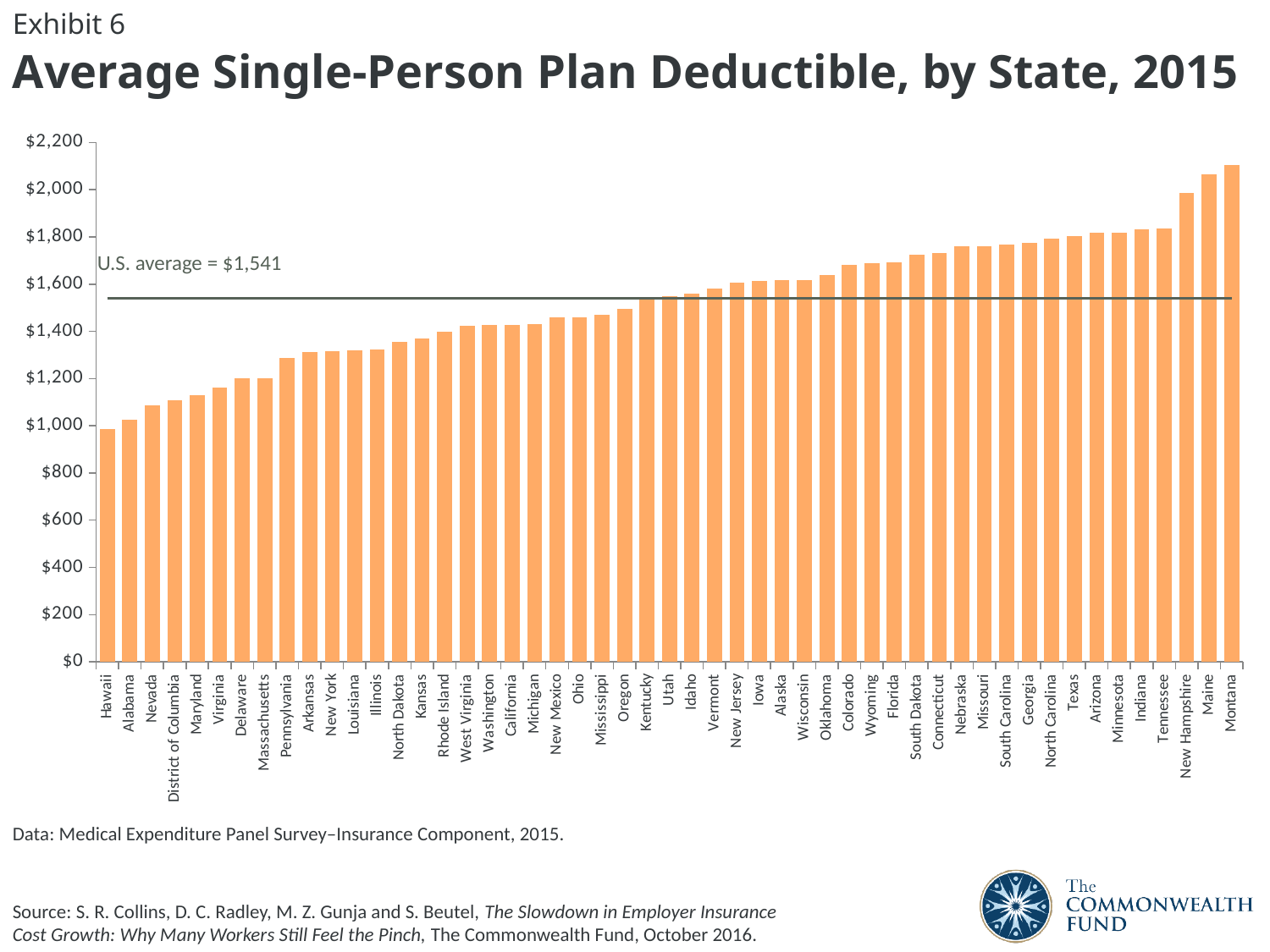
Which has a higher average deductible, Maine or Alabama? Maine Is the value for Texas greater or less than $1,600? greater Is the value for Montana greater or less than $2,000? greater How many states/jurisdictions are plotted on the chart? 51 Is the value for Delaware greater or less than $1,400? less Do the bar values rise or fall moving from left to right along the x axis? rise What is the title of the chart? Average Single-Person Plan Deductible, by State, 2015 What is the U.S. average single-person plan deductible shown on the chart? $1,541 Which state has the lowest average single-person plan deductible? Hawaii Which state has the highest average single-person plan deductible? Montana What type of chart is shown on the slide? bar chart